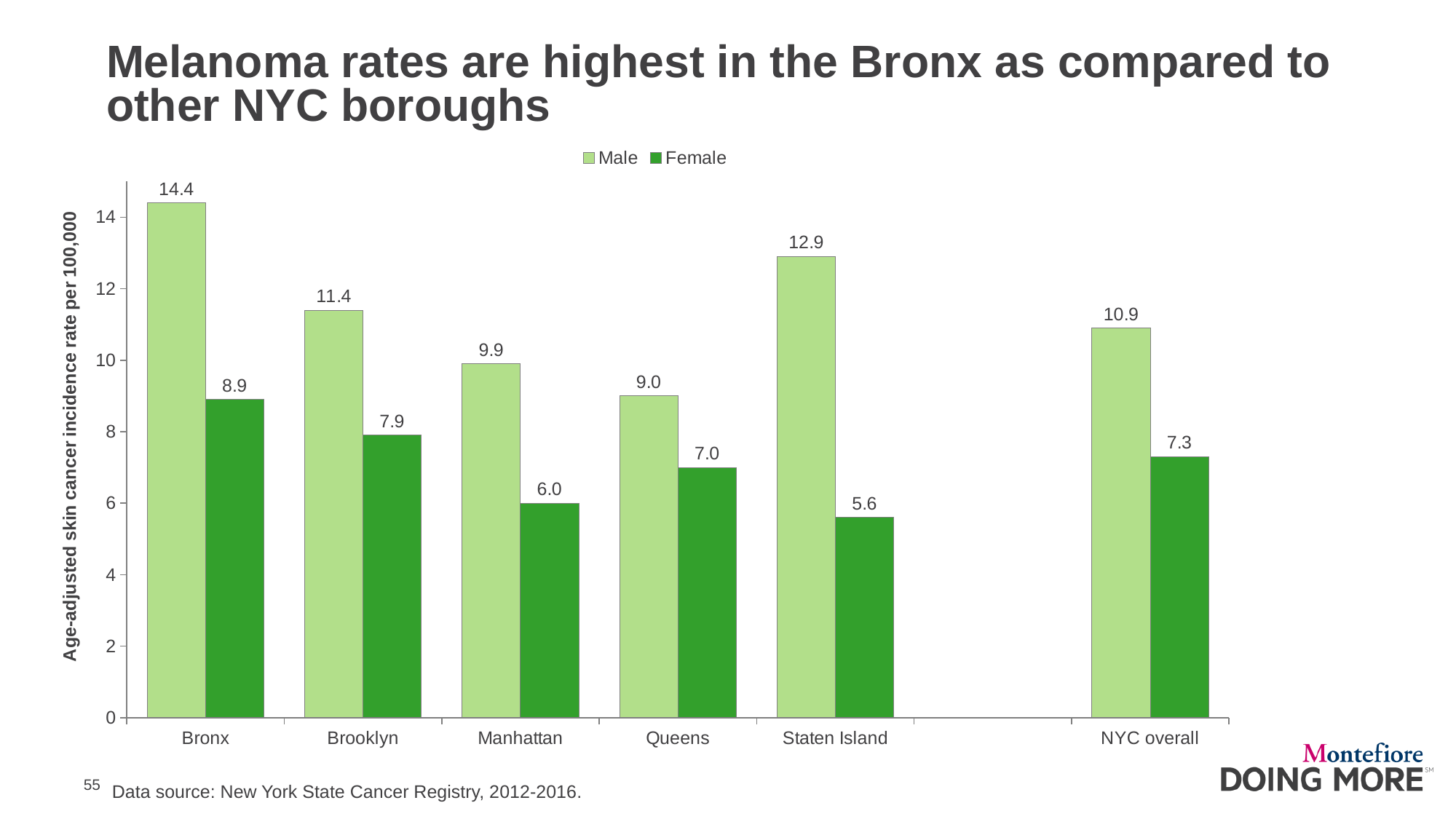
Is the Female value for Queens greater or less than 8? less What is the difference between the Male and Female rates for Brooklyn? 3.5 What kind of chart is shown on the slide? Bar chart What is the Female value for NYC overall? 7.3 How many categories are shown on the x axis? 6 Which is larger, the Male rate for Staten Island or the Male rate for Brooklyn? Staten Island Which category has the lowest Female melanoma incidence rate? Staten Island What is the Male melanoma incidence rate for the Bronx? 14.4 What is the label of the vertical axis? Age-adjusted skin cancer incidence rate per 100,000 What is the Female melanoma incidence rate for Staten Island? 5.6 Which borough has the highest Male melanoma incidence rate? Bronx How many series does the legend list? 2